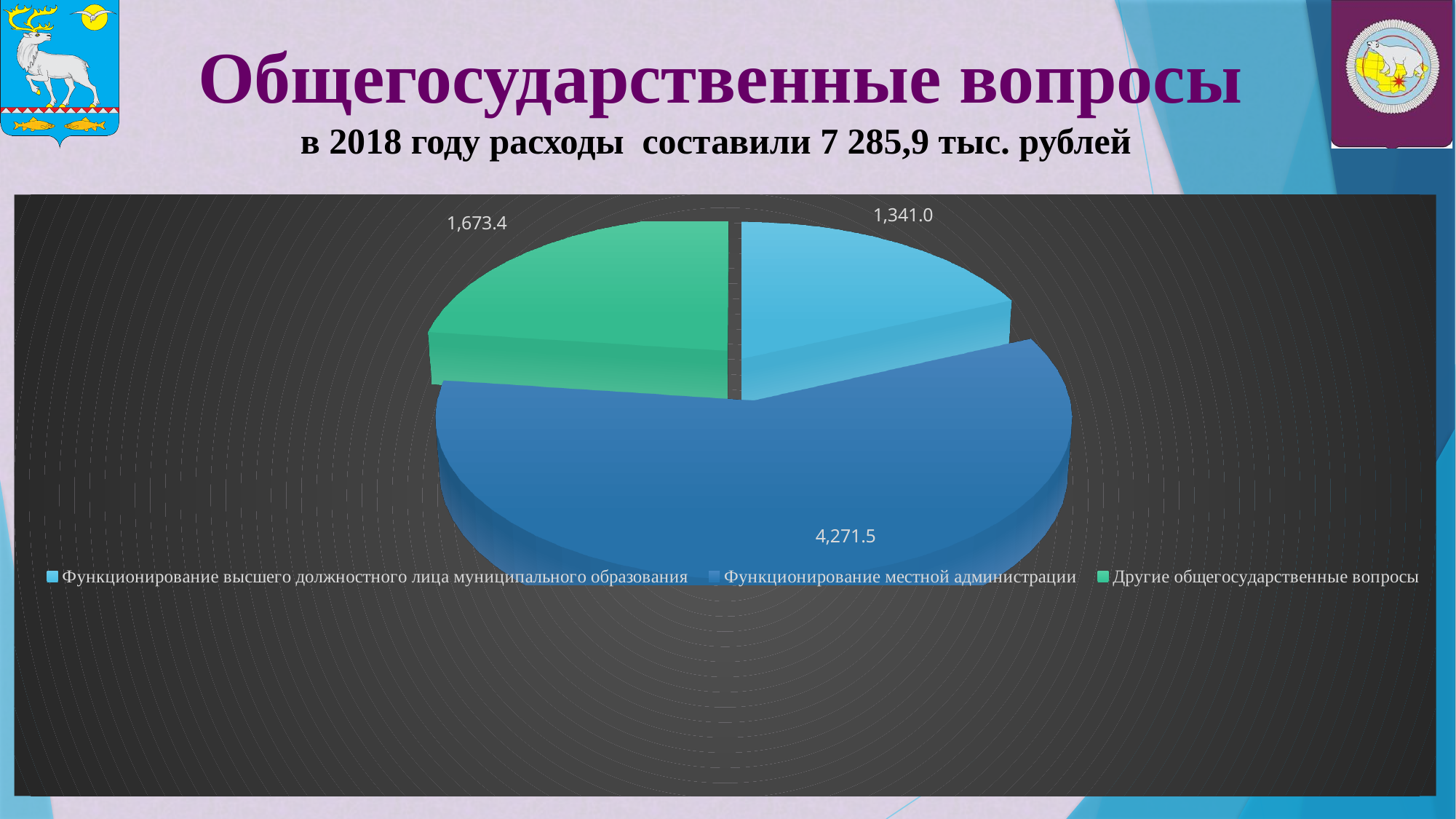
How many entries does the legend list? 3 What colour is the slice for Другие общегосударственные вопросы? Green What is the value for Функционирование местной администрации? 4,271.5 What kind of chart is shown on the slide? Pie chart How many slices does the pie chart have? 3 What is the difference between the values for Функционирование местной администрации and Другие общегосударственные вопросы? 2,598.1 What is the value for Функционирование высшего должностного лица муниципального образования? 1,341.0 What is the value for Другие общегосударственные вопросы? 1,673.4 Which category has the smallest slice? Функционирование высшего должностного лица муниципального образования What share of the pie does Функционирование местной администрации represent? 58.6% Which is larger: Другие общегосударственные вопросы or Функционирование высшего должностного лица муниципального образования? Другие общегосударственные вопросы Which category has the largest slice? Функционирование местной администрации